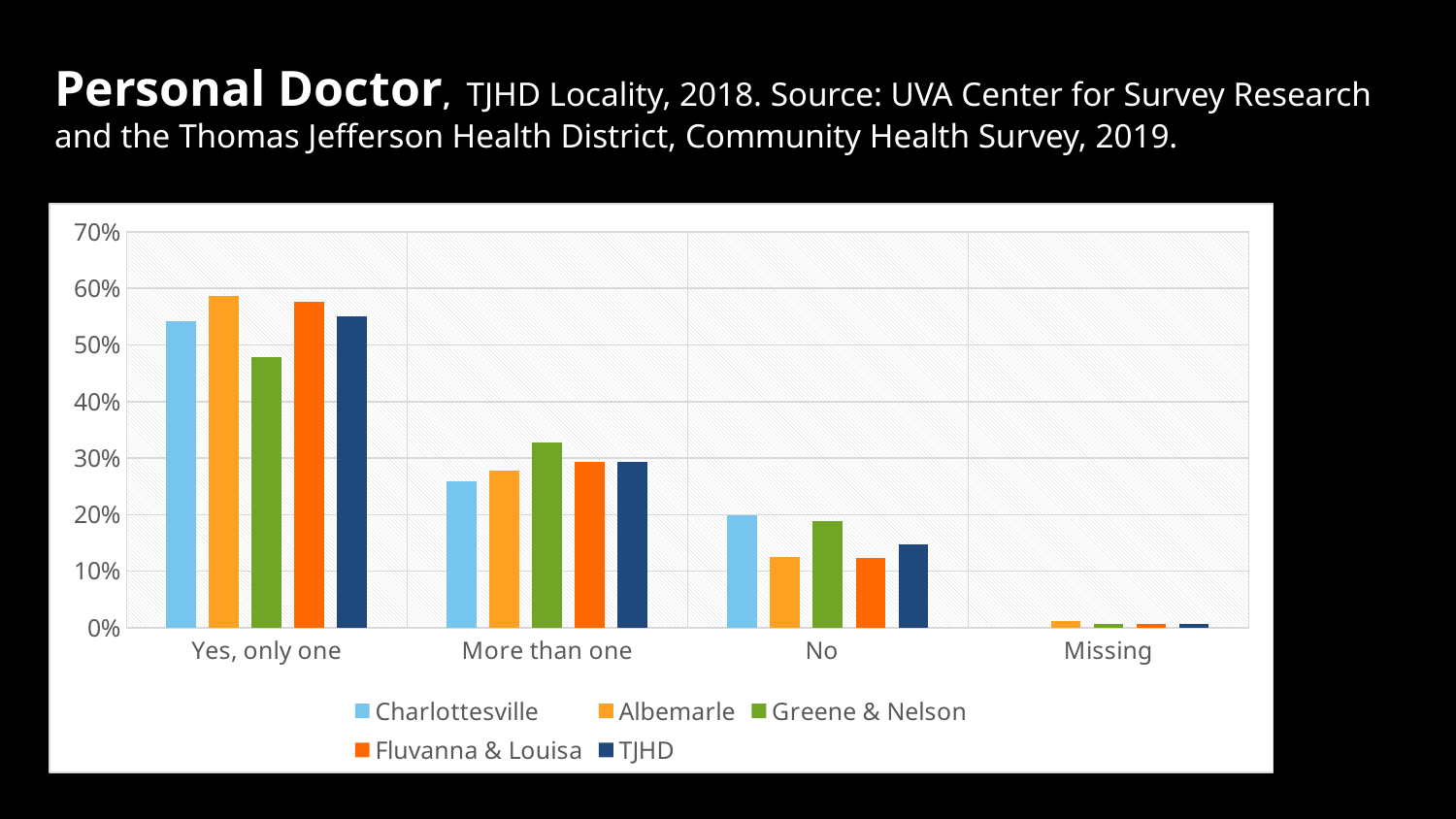
Is the value for Charlottesville in "Yes, only one" greater or less than 50%? greater Is the value for Greene & Nelson in "More than one" greater or less than 30%? greater What kind of chart is shown on the slide? Bar chart Which locality has the lowest value for "More than one"? Charlottesville Is the value for TJHD in "No" greater or less than 20%? less How many series does the legend list? 5 Which locality has the lowest value for "Yes, only one"? Greene & Nelson Which locality has the highest value for "More than one"? Greene & Nelson Do the Charlottesville values rise or fall moving from "Yes, only one" to "Missing" along the x axis? Fall For "No", which is larger: Charlottesville or Albemarle? Charlottesville How many response categories are shown on the x axis? 4